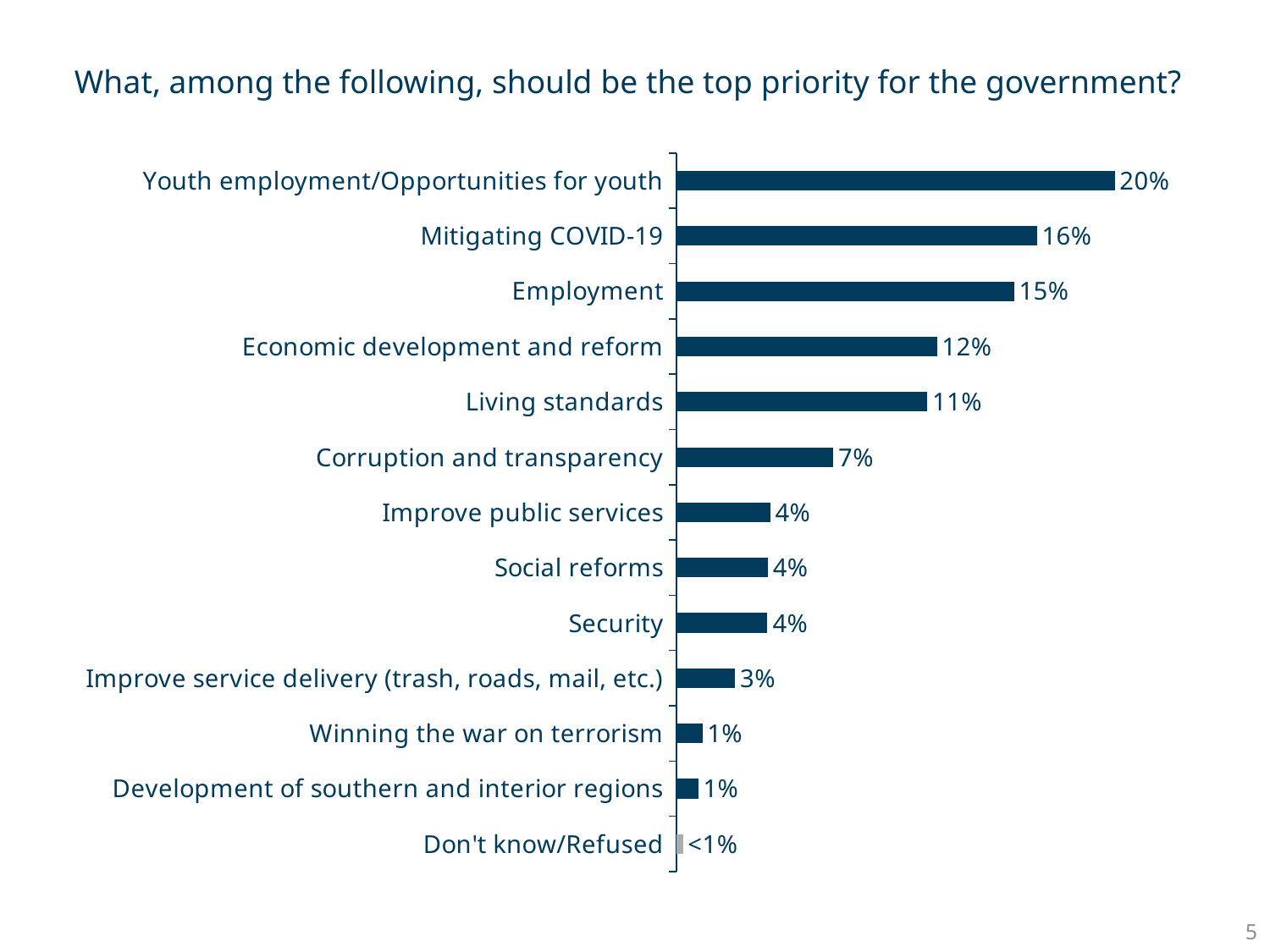
What is the difference between the values for Employment and Economic development and reform? 3% What percentage chose Youth employment/Opportunities for youth as the top priority? 20% What kind of chart is shown on the slide? Bar chart What is the value shown for Mitigating COVID-19? 16% Which category has the highest value? Youth employment/Opportunities for youth Which category has the lowest value? Don't know/Refused What is the title of the chart? What, among the following, should be the top priority for the government? How many categories are shown in the chart? 13 What is the difference between the values for Youth employment/Opportunities for youth and Living standards? 9% What value is shown for Improve service delivery (trash, roads, mail, etc.)? 3% Which is larger, the value for Mitigating COVID-19 or the value for Employment? Mitigating COVID-19 What percentage is shown for Corruption and transparency? 7%